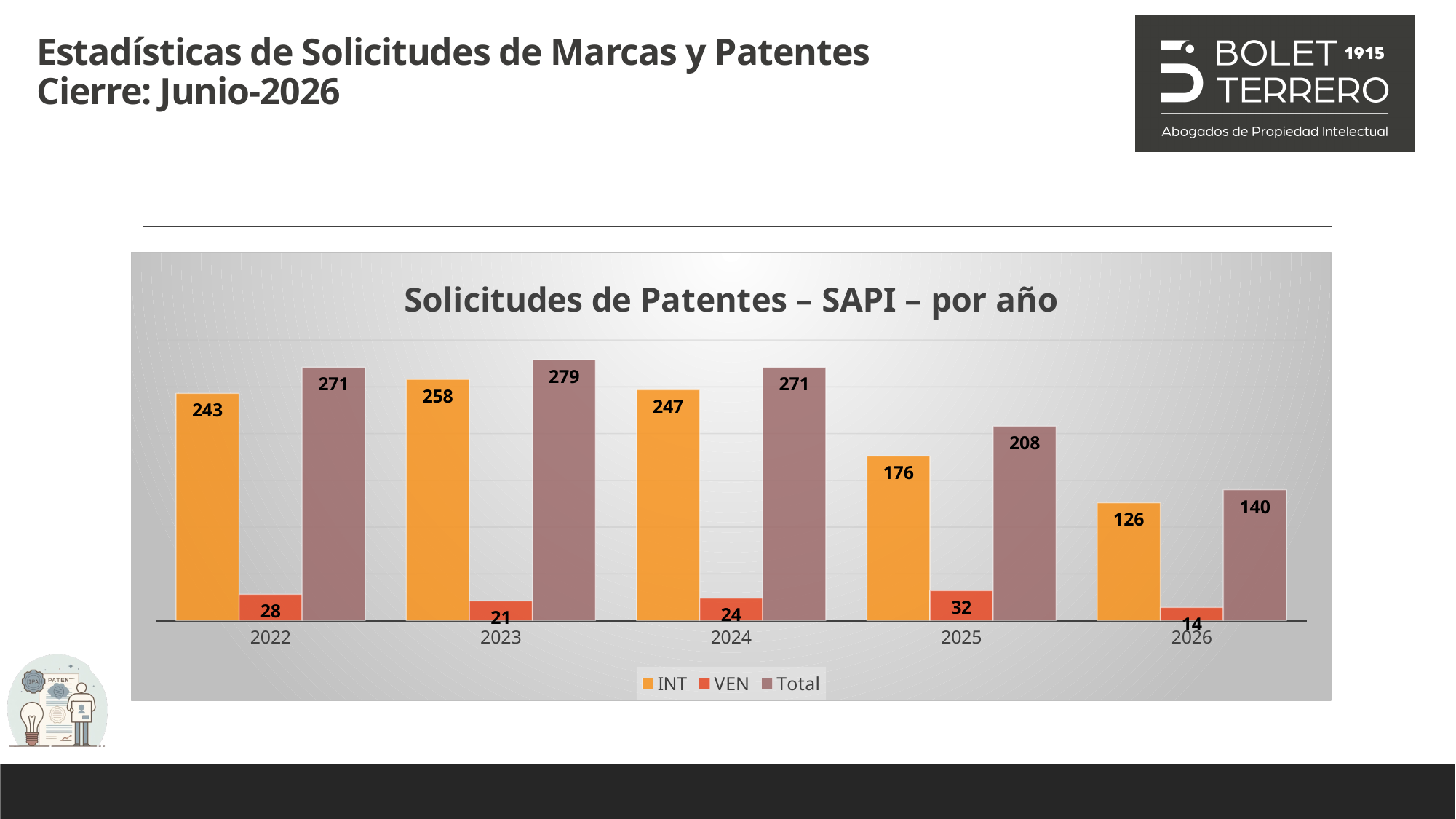
What is the difference between the Total values for 2024 and 2025? 63 What is the title of the chart? Solicitudes de Patentes – SAPI – por año What is the INT value for 2023? 258 How many years are shown on the x axis? 5 Which year has the lowest VEN value? 2026 What kind of chart is shown? Bar chart Do the Total values rise or fall from 2023 to 2026? Fall Which year has the highest Total value? 2023 What is the VEN value for 2025? 32 What is the Total value for 2026? 140 Which is larger, the INT value for 2022 or the INT value for 2024? 2024 How many series does the legend list? 3